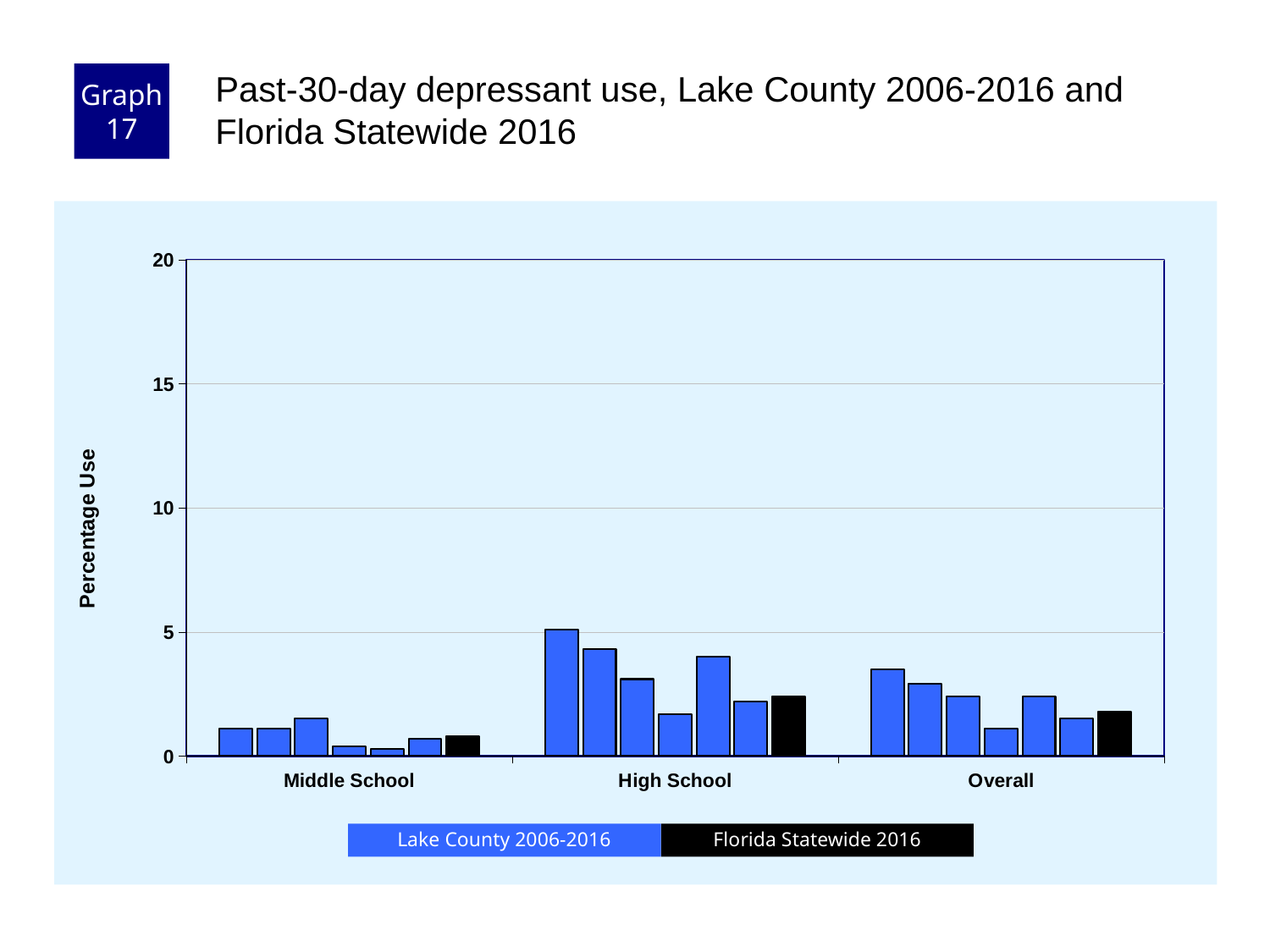
Which is larger, the Florida Statewide 2016 value for High School or for Middle School? High School How many school-level categories are shown on the x axis? 3 Is the Florida Statewide 2016 value for Middle School greater or less than 5? less Which colour represents Florida Statewide 2016 in the legend? black Which category has the highest Florida Statewide 2016 value? High School What is the label on the y axis? Percentage Use What kind of chart is shown on the slide? bar chart Is the Florida Statewide 2016 value for High School greater or less than 5? less How many series does the legend list? 2 Which category has the lowest Florida Statewide 2016 value? Middle School Is the tallest Lake County bar in the Overall group greater or less than 5? less